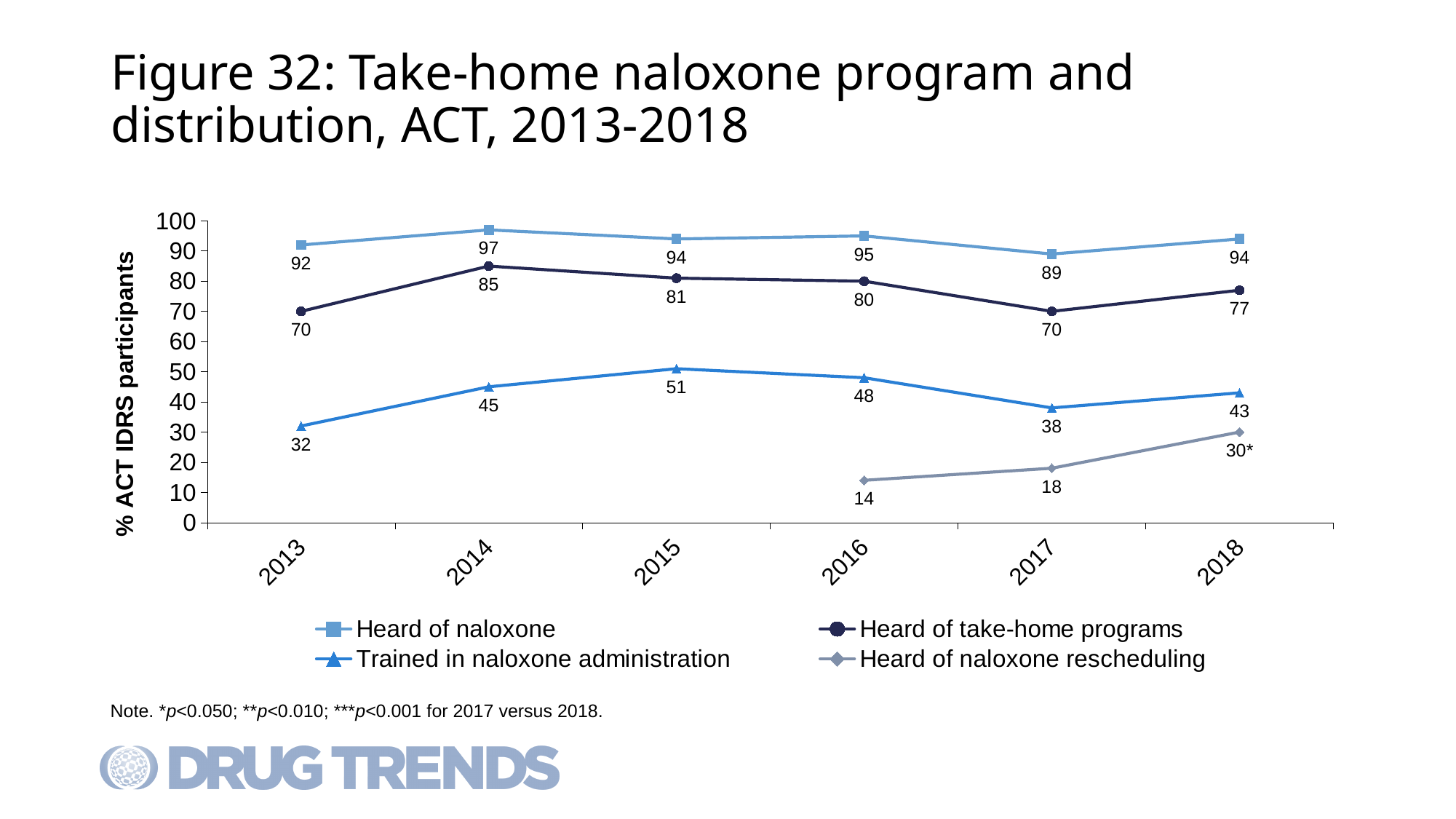
What is the value for 'Trained in naloxone administration' in 2015? 51 What is the value for 'Heard of take-home programs' in 2017? 70 In which year was 'Trained in naloxone administration' lowest? 2013 What is the difference between 'Heard of naloxone' and 'Heard of take-home programs' in 2013? 22 How many years are shown on the x axis? 6 What kind of chart is shown? Line chart Which series had the higher value in 2016: 'Trained in naloxone administration' or 'Heard of naloxone rescheduling'? Trained in naloxone administration What is the value for 'Heard of naloxone rescheduling' in 2018? 30* In which year was 'Heard of take-home programs' highest? 2014 What percentage of ACT IDRS participants had heard of naloxone in 2014? 97 How many series does the legend list? 4 Did the value for 'Heard of naloxone rescheduling' rise or fall from 2016 to 2018? Rise